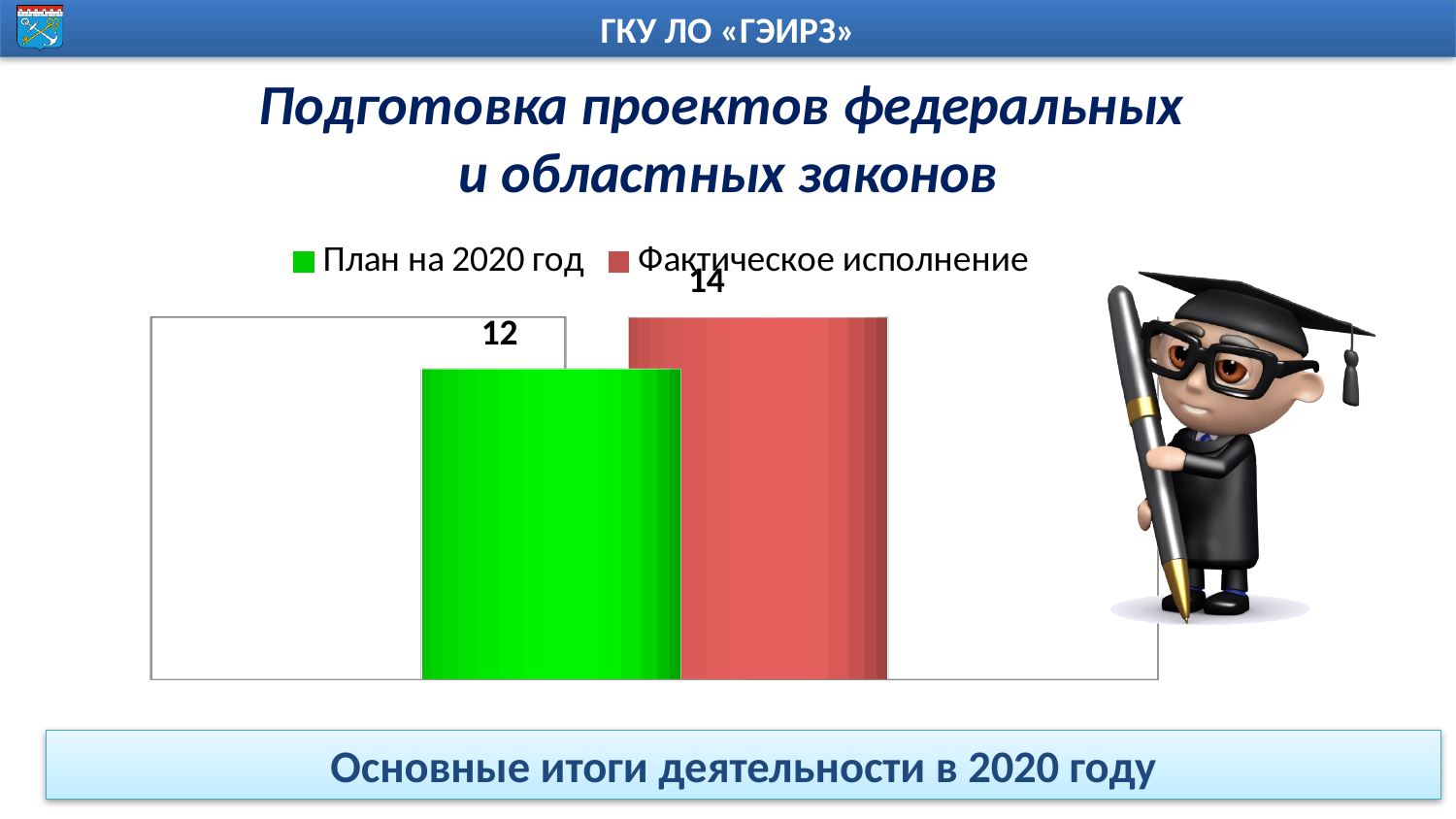
How many series does the legend list? 2 What kind of chart is shown on the slide? bar chart Which series has the highest value? Фактическое исполнение What colour is the bar for "План на 2020 год"? green Which series has the lowest value? План на 2020 год What colour is the bar for "Фактическое исполнение"? red What is the value for "План на 2020 год"? 12 What is the difference between "Фактическое исполнение" and "План на 2020 год"? 2 What is the value for "Фактическое исполнение"? 14 Which series has the higher value, "План на 2020 год" or "Фактическое исполнение"? Фактическое исполнение How many bars are plotted in the chart? 2